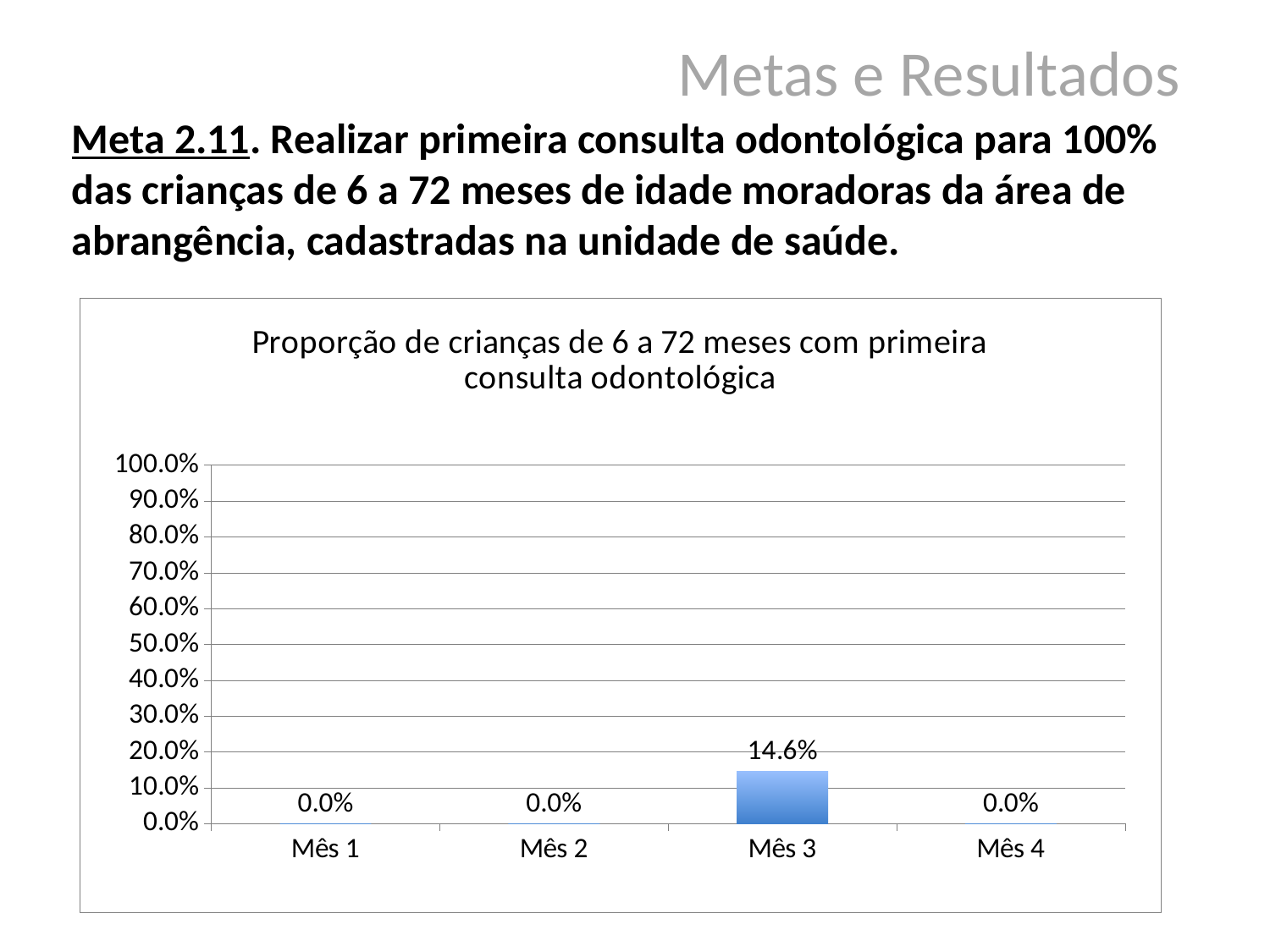
What is the maximum value shown on the y axis? 100.0% What is the value for Mês 1? 0.0% How many months have a value of 0.0%? 3 Is the value for Mês 3 greater or less than 20%? less What is the difference between the values for Mês 3 and Mês 2? 14.6% What kind of chart is shown on the slide? bar chart Which month has the highest value? Mês 3 What is the title of the chart? Proporção de crianças de 6 a 72 meses com primeira consulta odontológica Which is larger, the value for Mês 3 or the value for Mês 4? Mês 3 What is the value for Mês 4? 0.0% What is the value for Mês 3? 14.6% How many months are shown on the x axis? 4